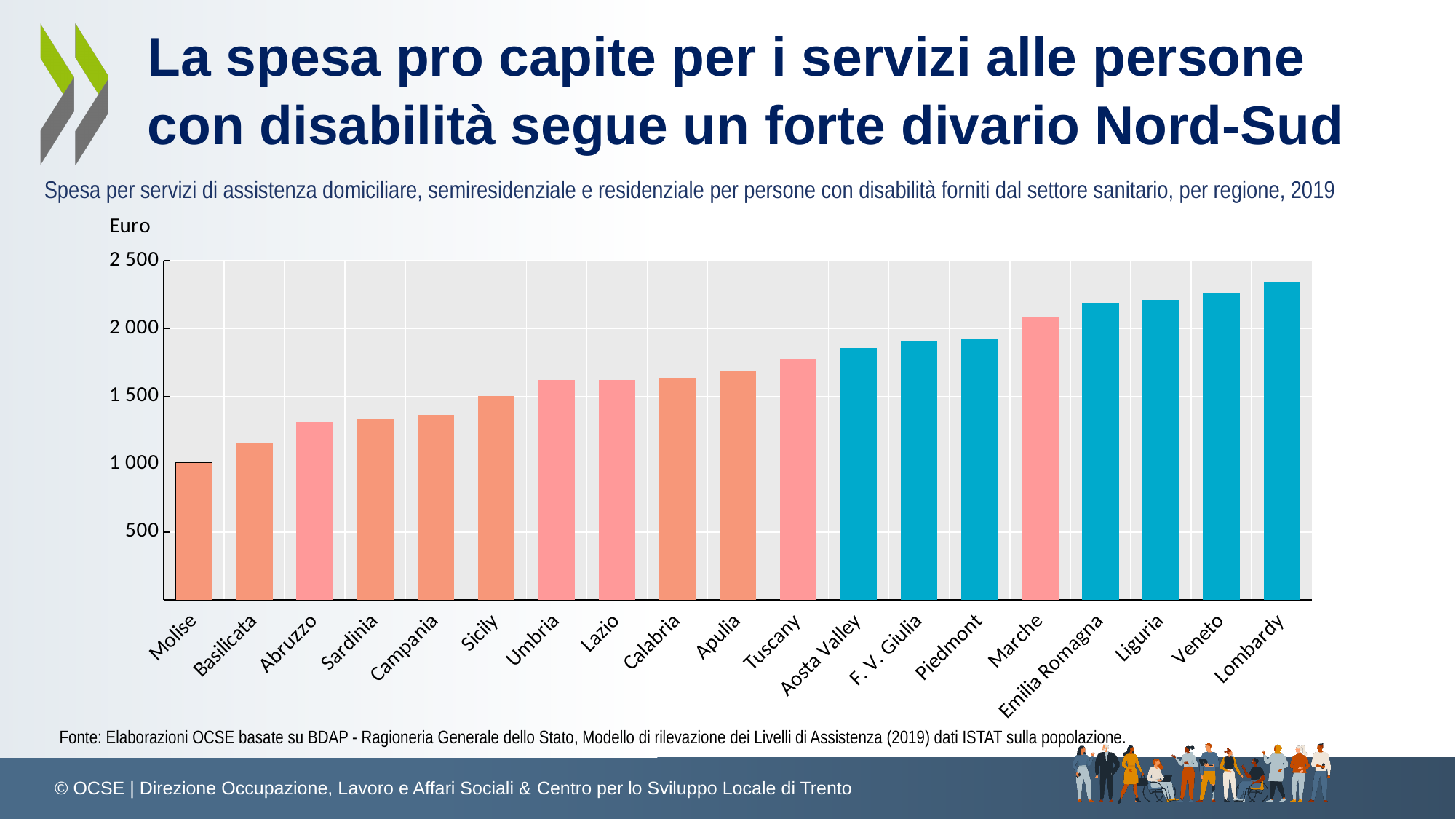
Is the value for Tuscany greater or less than 1 500? greater Is the value for Basilicata greater or less than 1 500? less Which has the larger value, Tuscany or Veneto? Veneto Which region has the highest per capita spending in the chart? Lombardy What unit is shown on the y axis of the chart? Euro Is the value for Aosta Valley greater or less than 2 000? less Do the bar values rise or fall from left to right along the x axis? rise What kind of chart is shown on the slide? bar chart Which has the larger value, Piedmont or Sardinia? Piedmont How many regions are shown in the chart? 19 Which region has the lowest per capita spending in the chart? Molise